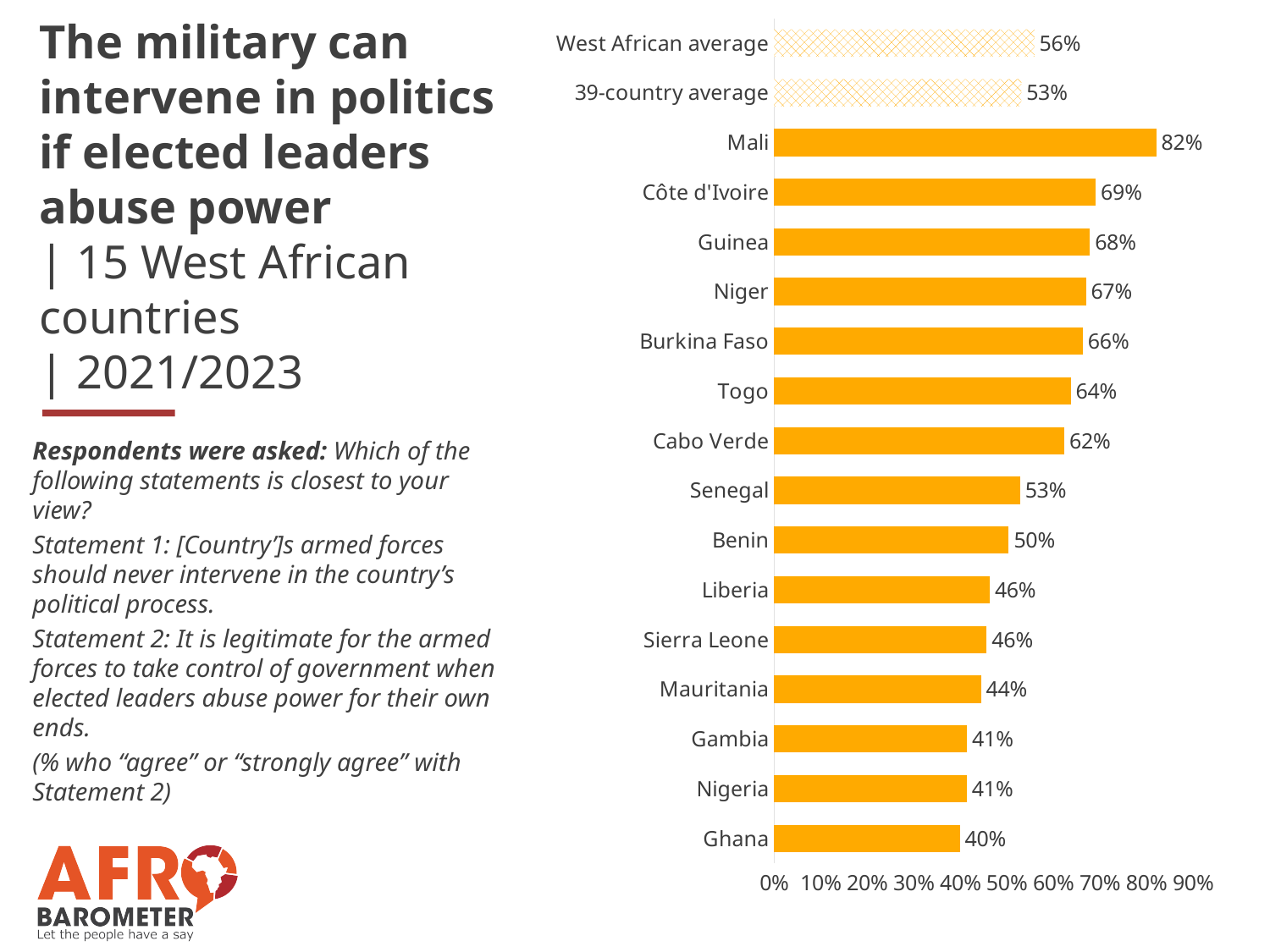
What is the value for the West African average? 56% Which country has the highest value? Mali Which is larger, the value for Togo or the value for Senegal? Togo How many countries are shown in the chart (excluding the two averages)? 15 What is the value for Mali? 82% What is the difference between the West African average and the 39-country average? 3% Is the value for Niger greater or less than 60%? greater What is the difference between the values for Mali and Ghana? 42% What kind of chart is shown on the slide? Bar chart What is the value for Mauritania? 44% Which country has the lowest value? Ghana What is the value for Cabo Verde? 62%